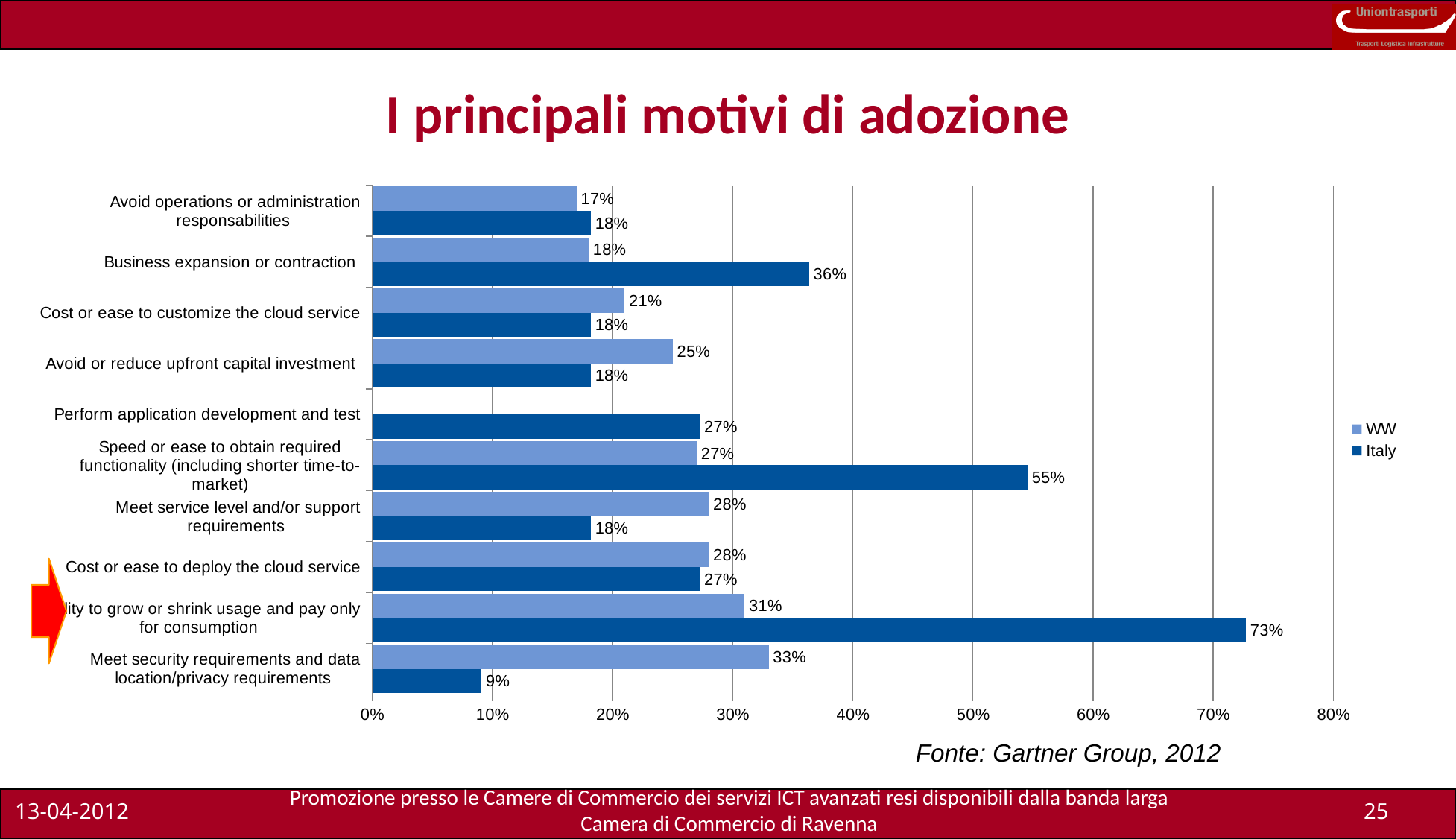
What is the Italy value for 'Speed or ease to obtain required functionality (including shorter time-to-market)'? 55% What is the WW value for 'Meet security requirements and data location/privacy requirements'? 33% What is the difference between the Italy and WW values for 'Business expansion or contraction'? 18% For 'Avoid or reduce upfront capital investment', which is larger, the WW value or the Italy value? WW How many categories are shown on the chart? 10 How many series does the legend list? 2 What kind of chart is shown on the slide? bar chart Which category has the highest Italy value? Ability to grow or shrink usage and pay only for consumption What source is cited below the chart? Fonte: Gartner Group, 2012 What is the Italy value for 'Business expansion or contraction'? 36% Is the Italy value for 'Ability to grow or shrink usage and pay only for consumption' greater or less than 70%? greater Which category has the lowest Italy value? Meet security requirements and data location/privacy requirements